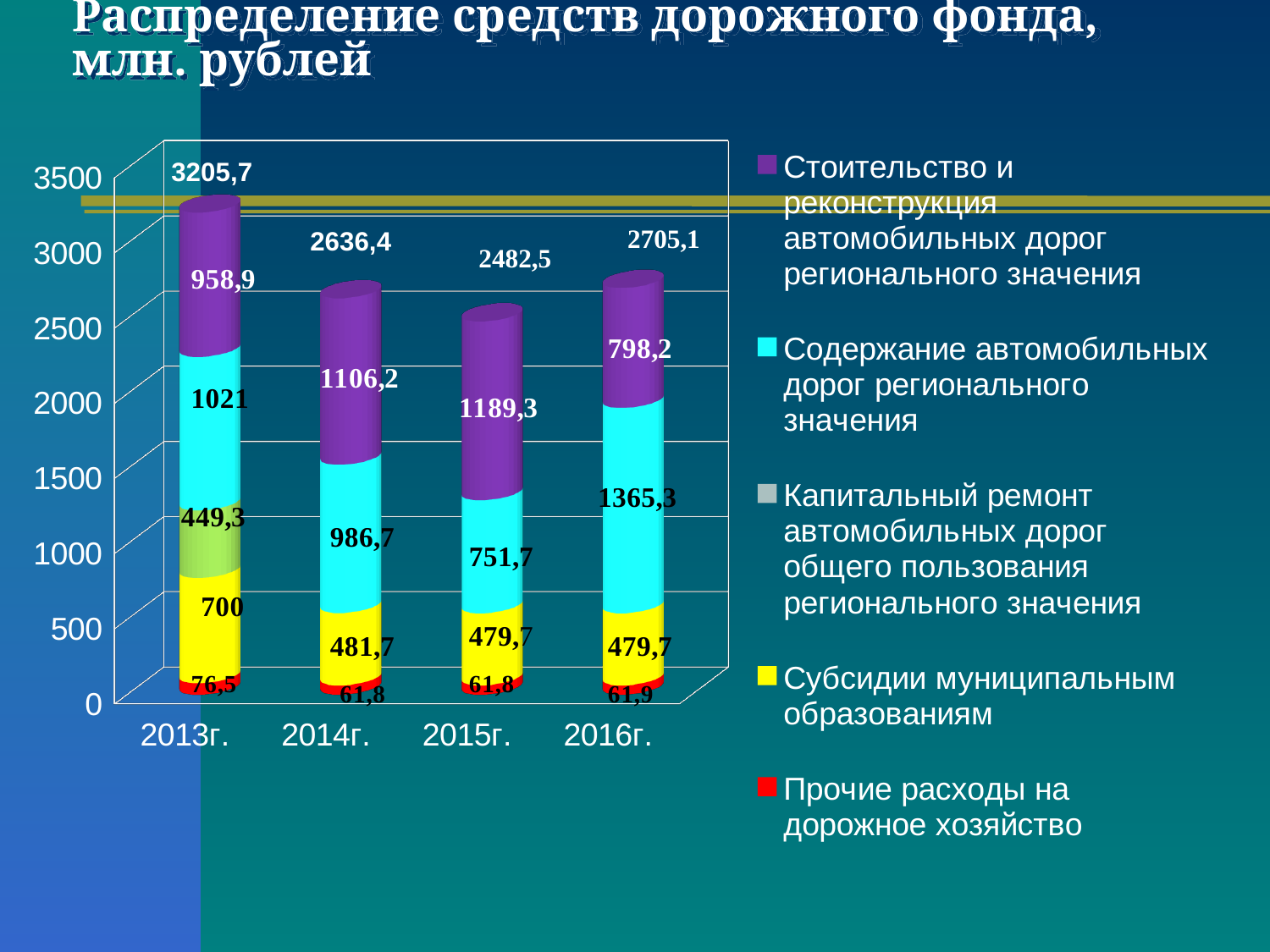
Какой тип диаграммы показан на слайде? Столбчатая диаграмма (с накоплением) В каком году общая сумма средств дорожного фонда была наибольшей? 2013г. Каково значение «Содержание автомобильных дорог регионального значения» в 2016г.? 1365,3 Какова общая сумма средств дорожного фонда в 2015г.? 2482,5 Какой цвет обозначает «Прочие расходы на дорожное хозяйство» в легенде? Красный В каком году общая сумма средств дорожного фонда была наименьшей? 2015г. Каково значение «Субсидии муниципальным образованиям» в 2014г.? 481,7 Что больше: «Строительство и реконструкция автомобильных дорог регионального значения» в 2015г. или в 2016г.? 2015г. Сколько категорий (лет) показано на диаграмме? 4 Какова общая сумма средств дорожного фонда в 2013г.? 3205,7 На сколько общая сумма в 2016г. больше, чем в 2015г.? 222,6 Сколько рядов данных перечислено в легенде диаграммы? 5